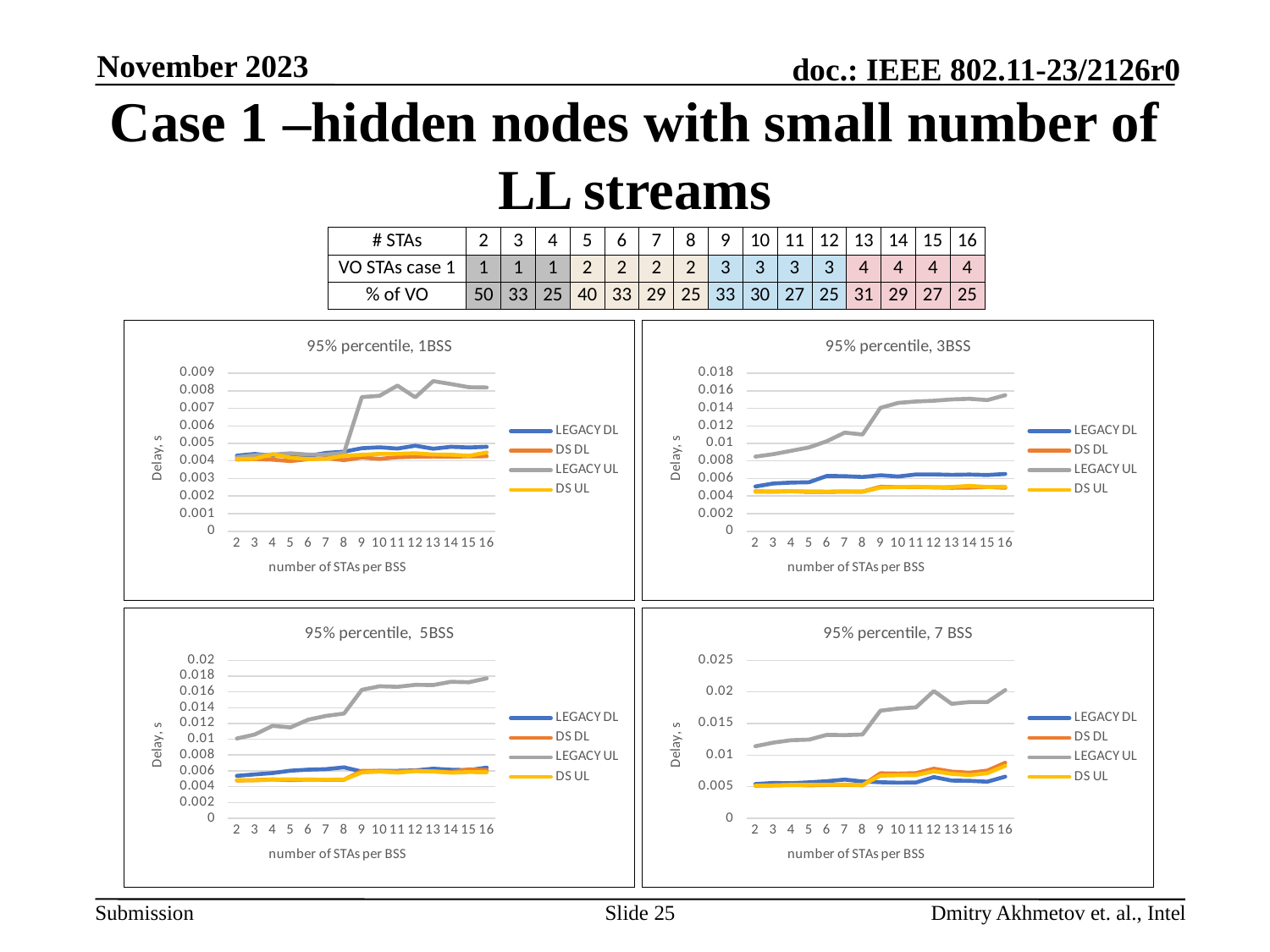
What type of chart is the '95% percentile, 1BSS' chart? line chart In the '95% percentile, 1BSS' chart, is the LEGACY UL value at 13 STAs per BSS greater or less than 0.008? greater What is the y-axis label of the '95% percentile, 7 BSS' chart? Delay, s In the '95% percentile, 5BSS' chart, does the LEGACY UL series generally rise or fall as the number of STAs per BSS increases? rise In the '95% percentile, 7 BSS' chart, is the LEGACY UL value at 2 STAs per BSS greater or less than 0.01? greater In the '95% percentile, 1BSS' chart, which series has the highest delay at 16 STAs per BSS? LEGACY UL How many x-axis points (numbers of STAs per BSS) are plotted in the '95% percentile, 5BSS' chart? 15 How many series does the legend of the '95% percentile, 3BSS' chart list? 4 In the '95% percentile, 3BSS' chart, is the LEGACY UL value at 16 STAs per BSS greater or less than 0.014? greater In the '95% percentile, 7 BSS' chart, which is larger at 16 STAs per BSS: LEGACY UL or LEGACY DL? LEGACY UL